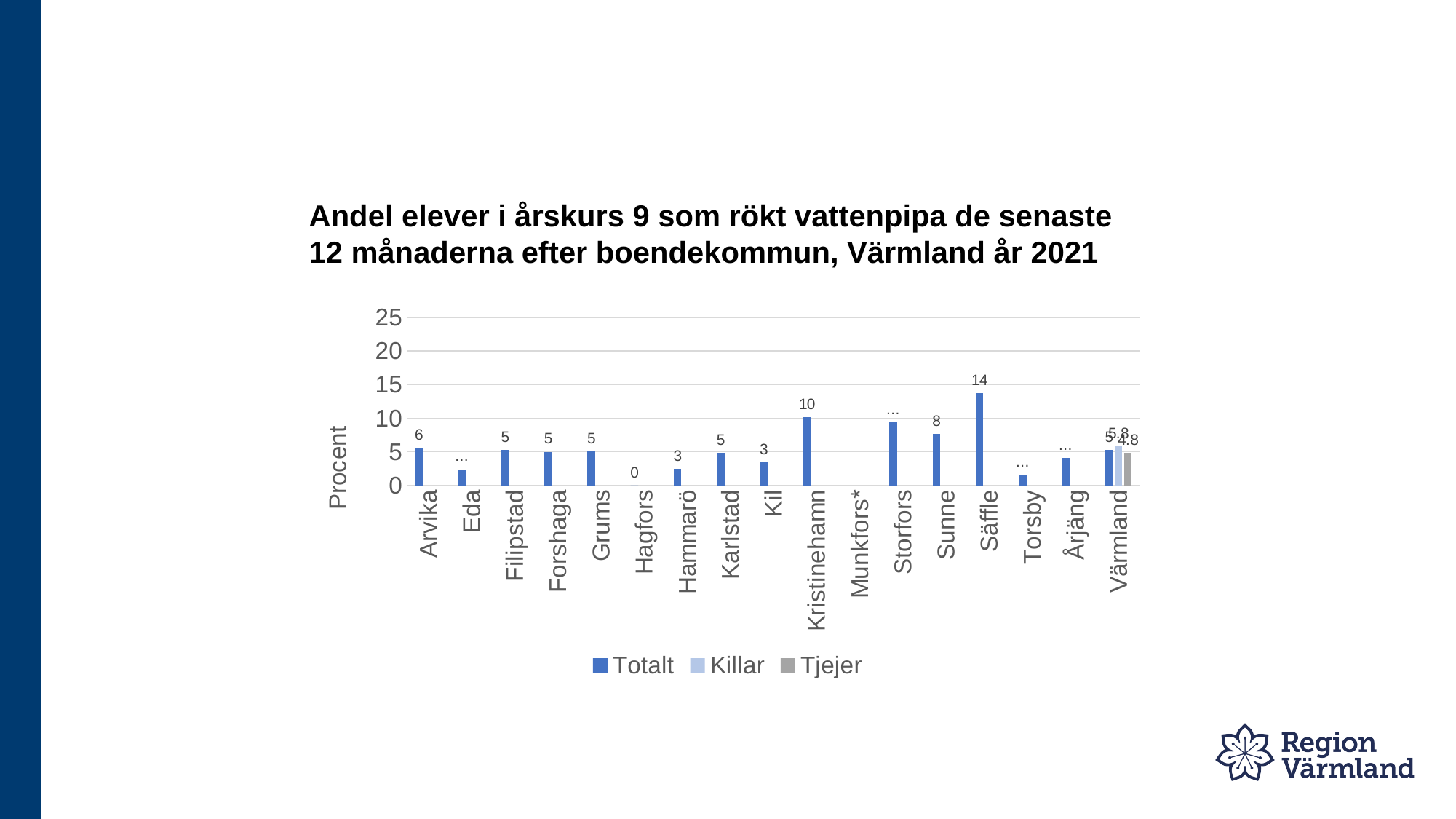
Which municipality has the lowest labelled Totalt value? Hagfors Which has a higher Totalt value, Kristinehamn or Sunne? Kristinehamn What type of chart is shown on the slide? bar chart How many series does the legend list? 3 What is the Totalt value for Kristinehamn? 10 What is the Totalt value for Hagfors? 0 Is the Totalt value for Storfors greater or less than 5? greater What is the label on the vertical axis? Procent What is the difference between the Totalt values for Säffle and Kristinehamn? 4 What is the Totalt value for Säffle? 14 What is the Tjejer value for Värmland? 4.8 Which municipality has the highest Totalt value? Säffle